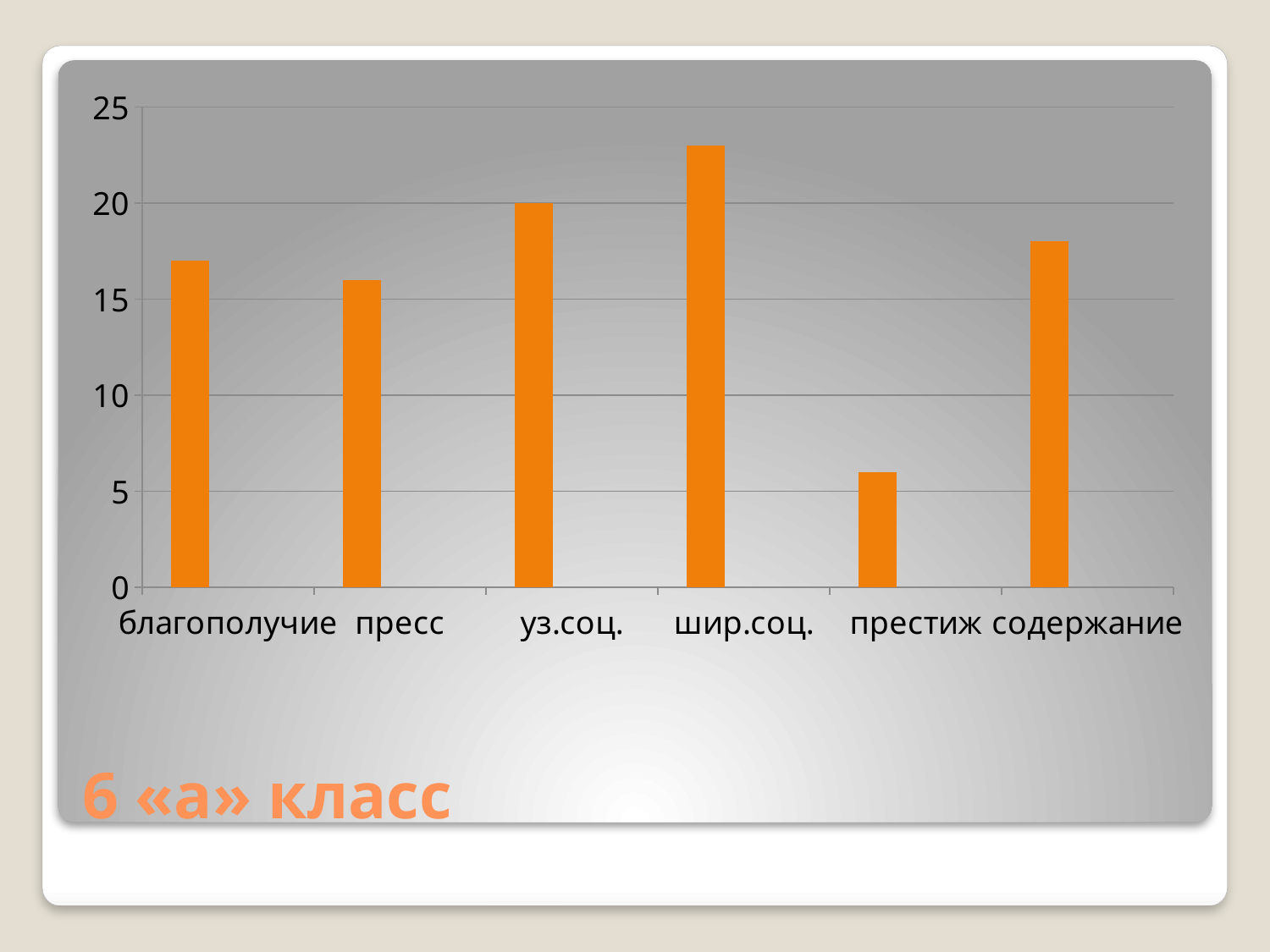
What is the value for уз.соц.? 20 Is the value for содержание greater or less than 20? less What kind of chart is shown on the slide? bar chart Is the value for престиж greater or less than 10? less Which category has the highest bar? шир.соц. Is the value for благополучие greater or less than 15? greater Which category has the lowest bar? престиж Which is larger, the value for содержание or the value for пресс? содержание What is the title shown on the chart slide? 6 «а» класс Which is larger, the value for уз.соц. or the value for престиж? уз.соц. How many categories are shown on the x axis of the chart? 6